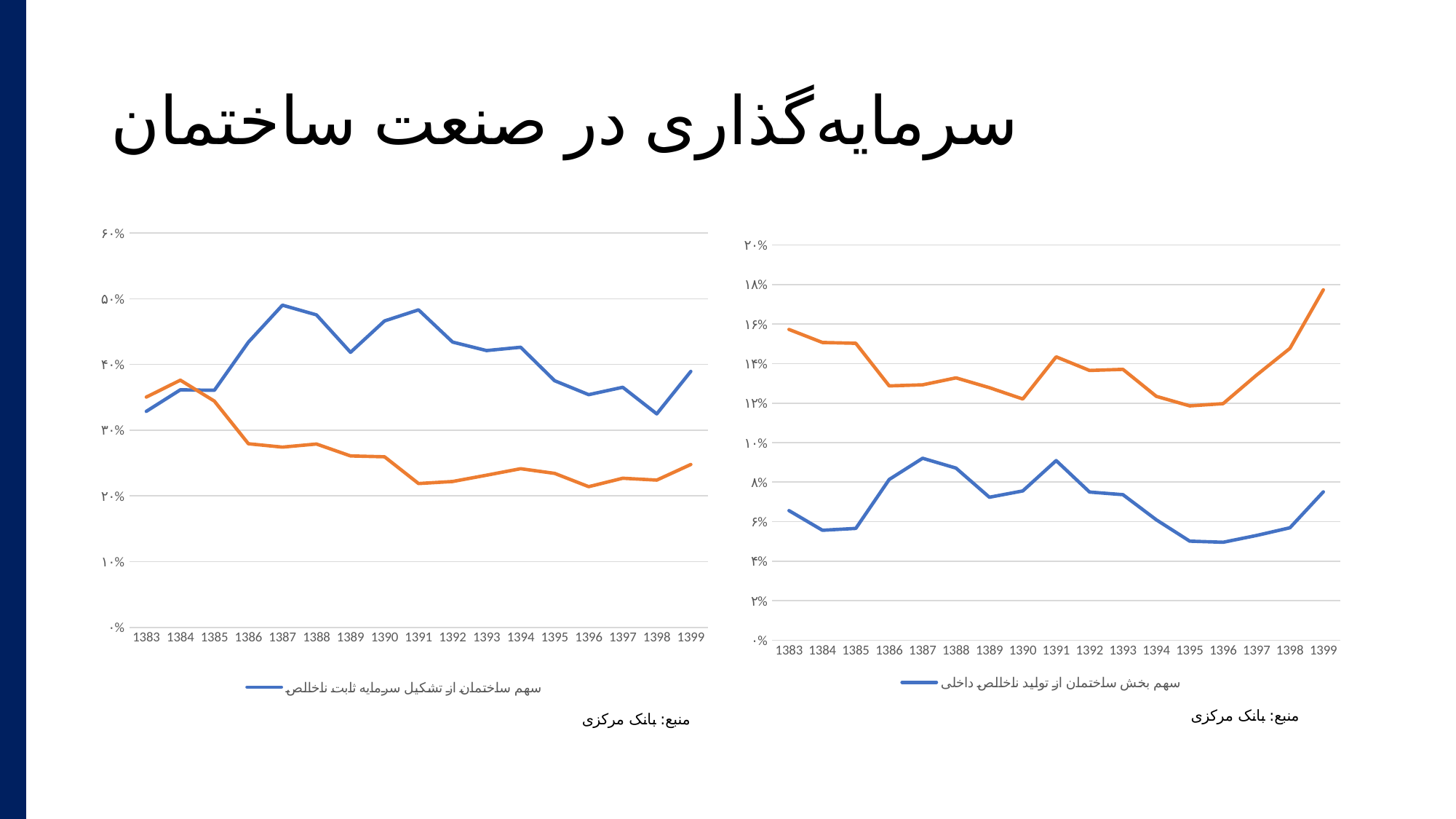
In the right chart, which year has the highest value on the orange line? 1399 How many years are shown on the x axis of the right chart? 17 In the left chart, does the orange line rise or fall overall from 1384 to 1396? fall In the left chart, is the value of the blue line for 1387 greater or less than 40%? greater In the left chart, is the value of the orange line for 1396 greater or less than 30%? less In the left chart, which year has the highest value on the orange line? 1384 In the left chart, which line has the larger value in 1387, the blue line or the orange line? blue line What kind of chart is the left chart on the slide? line chart What source is cited below the charts? منبع: بانک مرکزی In the right chart, is the value of the orange line for 1399 greater or less than 16%? greater How many series does the legend of the left chart list? 1